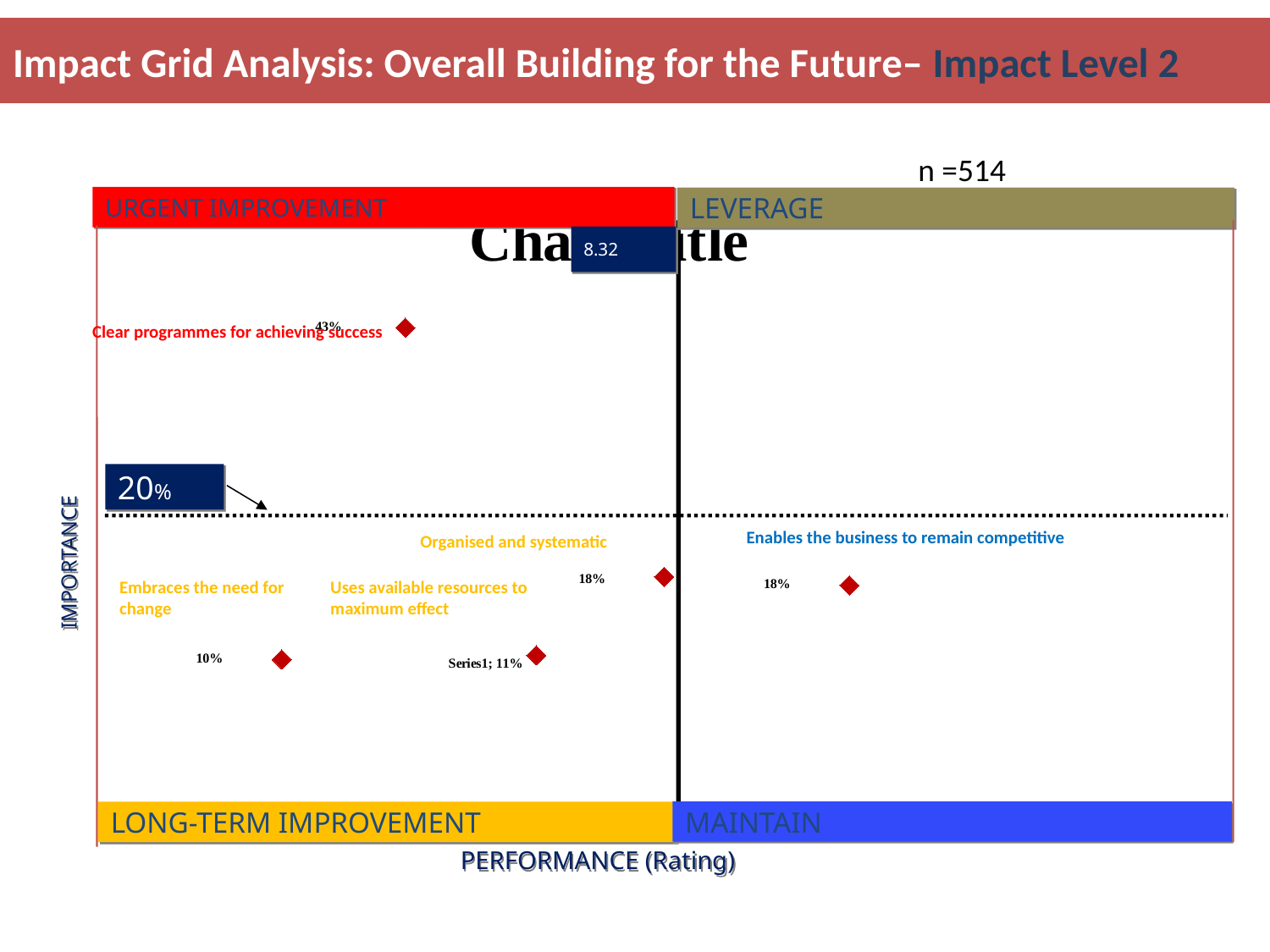
Is the importance value for 'Organised and systematic' greater or less than 20%? less Which quadrant of the grid is labelled in the top right? LEVERAGE What is the importance value shown for 'Enables the business to remain competitive'? 18% What is the difference in importance between 'Clear programmes for achieving success' and 'Organised and systematic'? 25% Which has the larger importance value, 'Embraces the need for change' or 'Uses available resources to maximum effect'? Uses available resources to maximum effect How many data points are plotted on the impact grid? 5 Which item has the highest importance value on the grid? Clear programmes for achieving success What kind of chart is shown on the slide? Scatter chart What is the importance value shown for 'Clear programmes for achieving success'? 43% What is the importance value shown for 'Uses available resources to maximum effect'? 11% What is the importance value shown for 'Embraces the need for change'? 10% Which item has the lowest importance value on the grid? Embraces the need for change